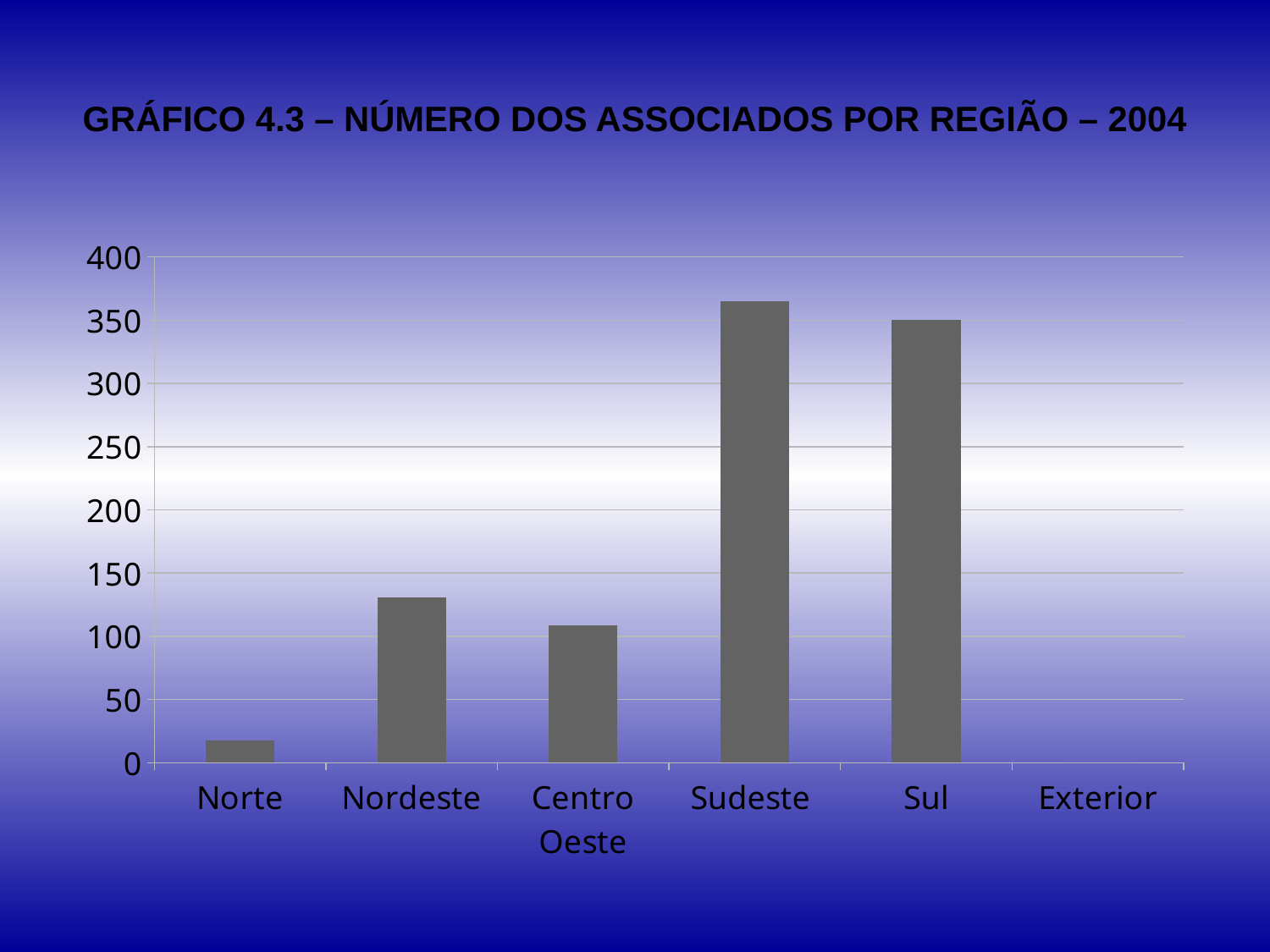
Is the value for Norte greater or less than 50? less Is the value for Sudeste greater or less than 350? greater Is the value for Nordeste greater or less than 100? greater Which has more associates, Nordeste or Centro Oeste? Nordeste Which region has the highest number of associates? Sudeste How many regions are shown on the x axis of the chart? 6 What kind of chart is shown on the slide? bar chart What is the title of the chart? GRÁFICO 4.3 – NÚMERO DOS ASSOCIADOS POR REGIÃO – 2004 Which has more associates, Sudeste or Sul? Sudeste Which region has the lowest number of associates? Exterior